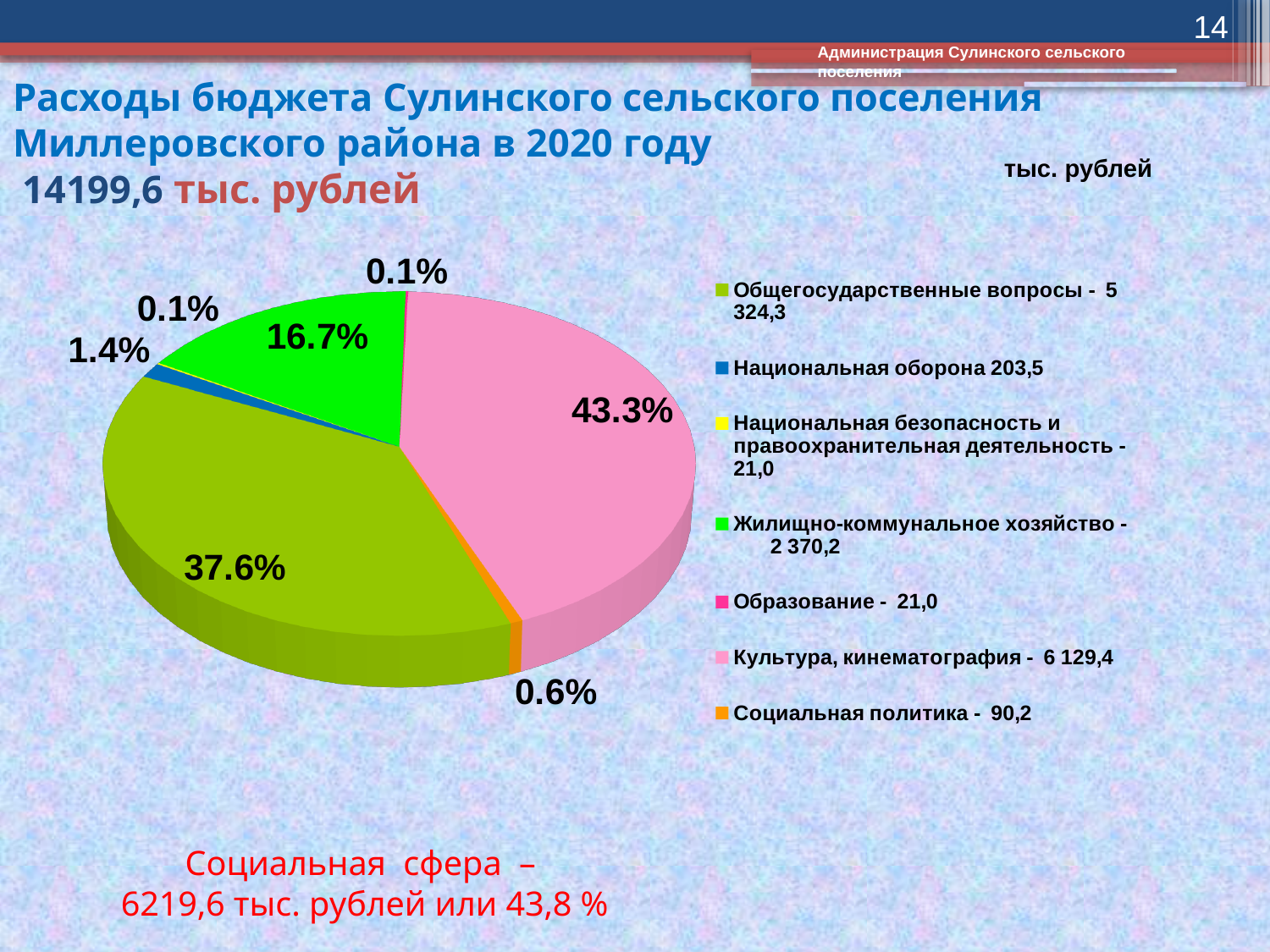
What value (тыс. рублей) does the legend give for Жилищно-коммунальное хозяйство? 2 370,2 What share of the pie does Культура, кинематография take? 43.3% What value (тыс. рублей) does the legend give for Социальная политика? 90,2 What kind of chart is shown on the slide? pie chart By how many percentage points does the Культура, кинематография slice exceed the Общегосударственные вопросы slice? 5.7 What share of the pie does Общегосударственные вопросы take? 37.6% Which category has the largest slice of the pie? Культура, кинематография Which is larger: the slice for Общегосударственные вопросы or the slice for Жилищно-коммунальное хозяйство? Общегосударственные вопросы What share of the pie does Жилищно-коммунальное хозяйство take? 16.7% How many categories does the legend of the pie chart list? 7